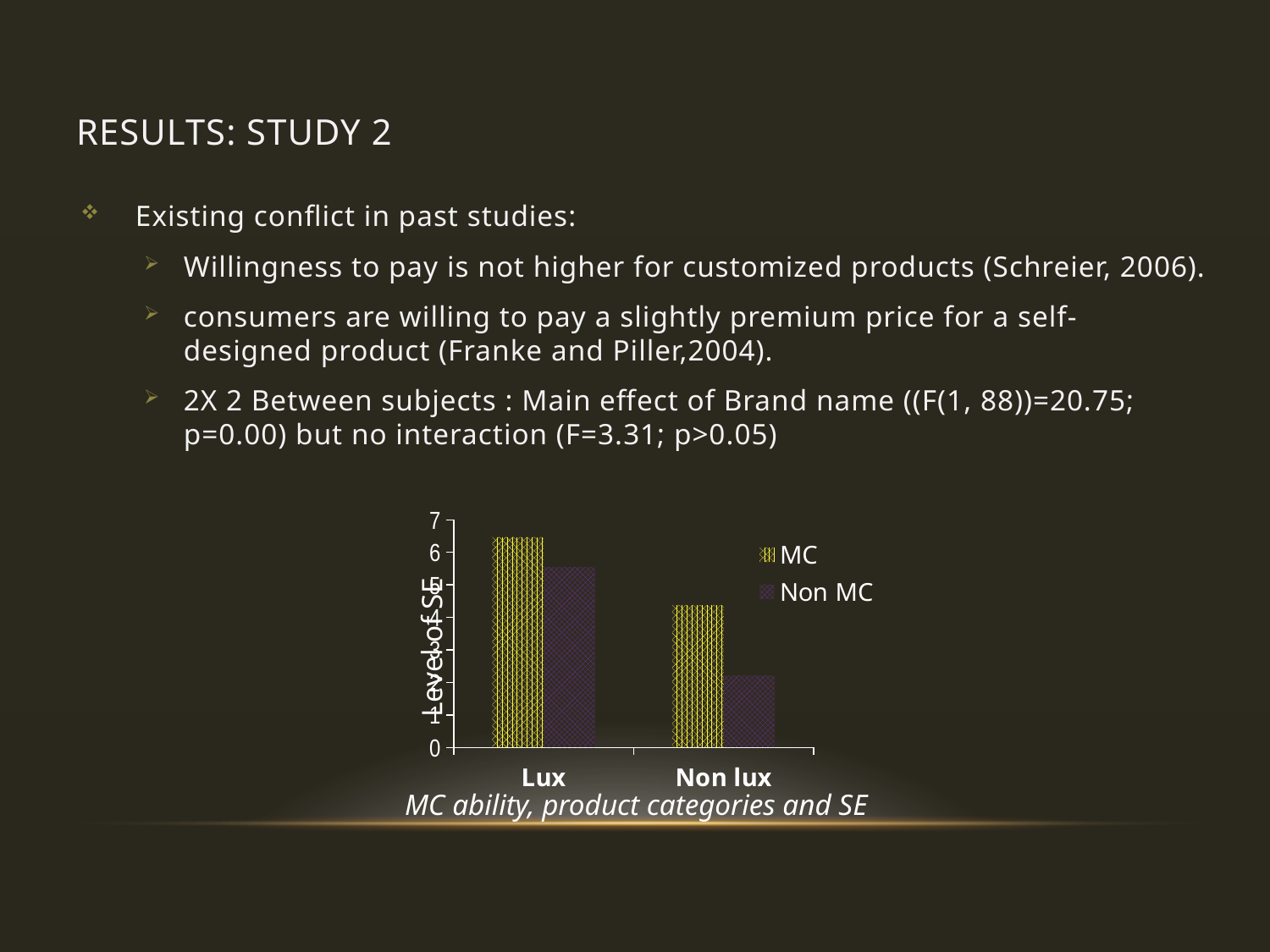
What kind of chart is shown on the slide? bar chart What is the title of the chart? MC ability, product categories and SE Is the MC value for Lux greater or less than 6? greater What are the two series listed in the chart's legend? MC and Non MC Which category has the highest MC bar? Lux For the Non lux category, which is larger: the MC bar or the Non MC bar? MC Which category has the lowest Non MC bar? Non lux How many categories are shown on the x axis of the chart? 2 For the Lux category, which is larger: the MC bar or the Non MC bar? MC Do the MC values rise or fall from Lux to Non lux? fall Is the Non MC value for Non lux greater or less than 3? less How many series does the chart's legend list? 2